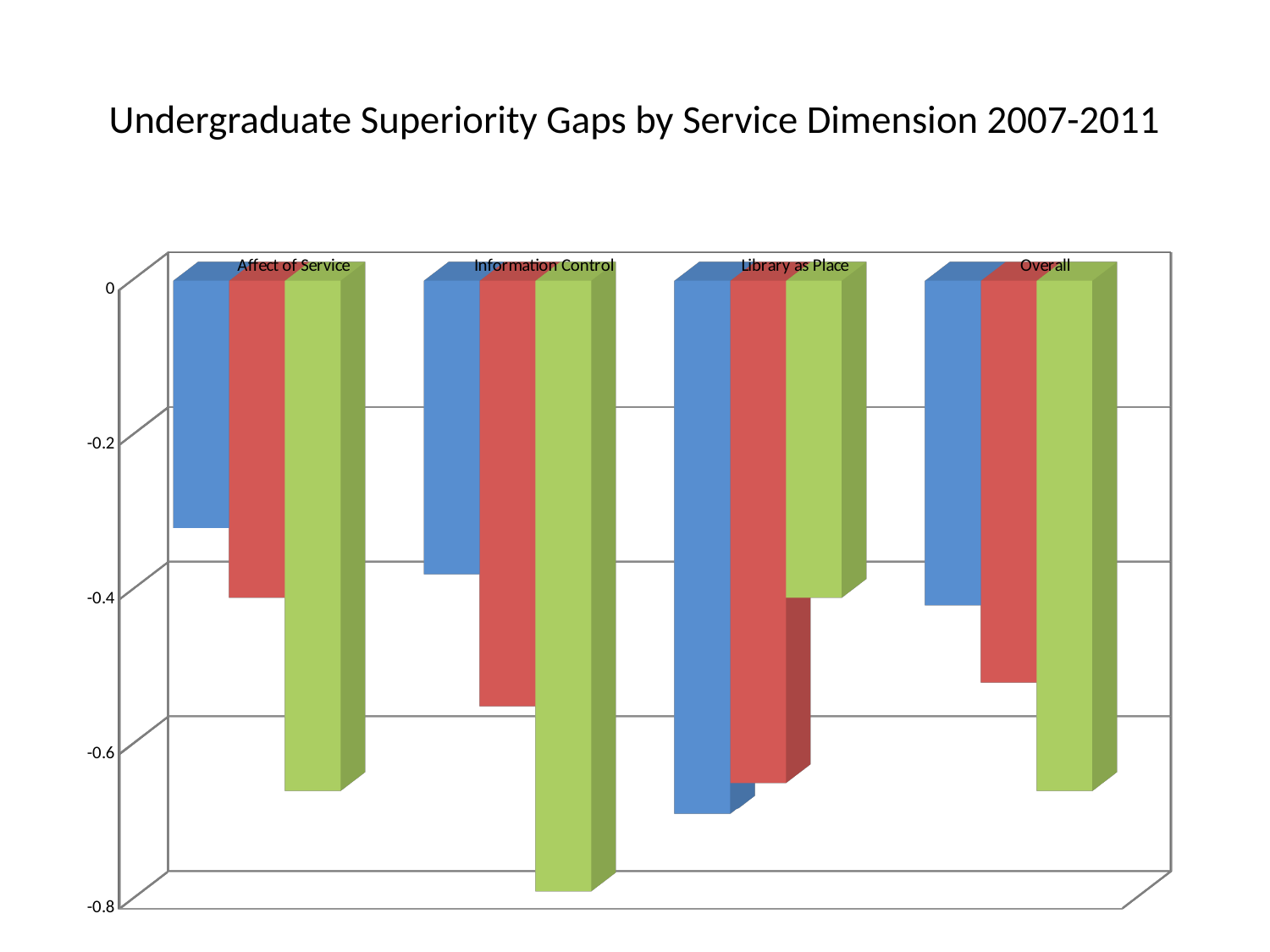
How many service dimension categories are shown on the x axis? 4 How many bars are plotted for each category? 3 Which category has the lowest (most negative) blue bar? Library as Place Is the value of the red bar for Information Control greater or less than -0.4? less Which category has the lowest (most negative) green bar? Information Control What is the title of the chart? Undergraduate Superiority Gaps by Service Dimension 2007-2011 Is the value of the red bar for Overall greater or less than -0.6? greater What kind of chart is shown on the slide? bar chart Is the value of the blue bar for Affect of Service greater or less than -0.4? greater Which is more negative: the green bar for Information Control or the green bar for Affect of Service? Information Control